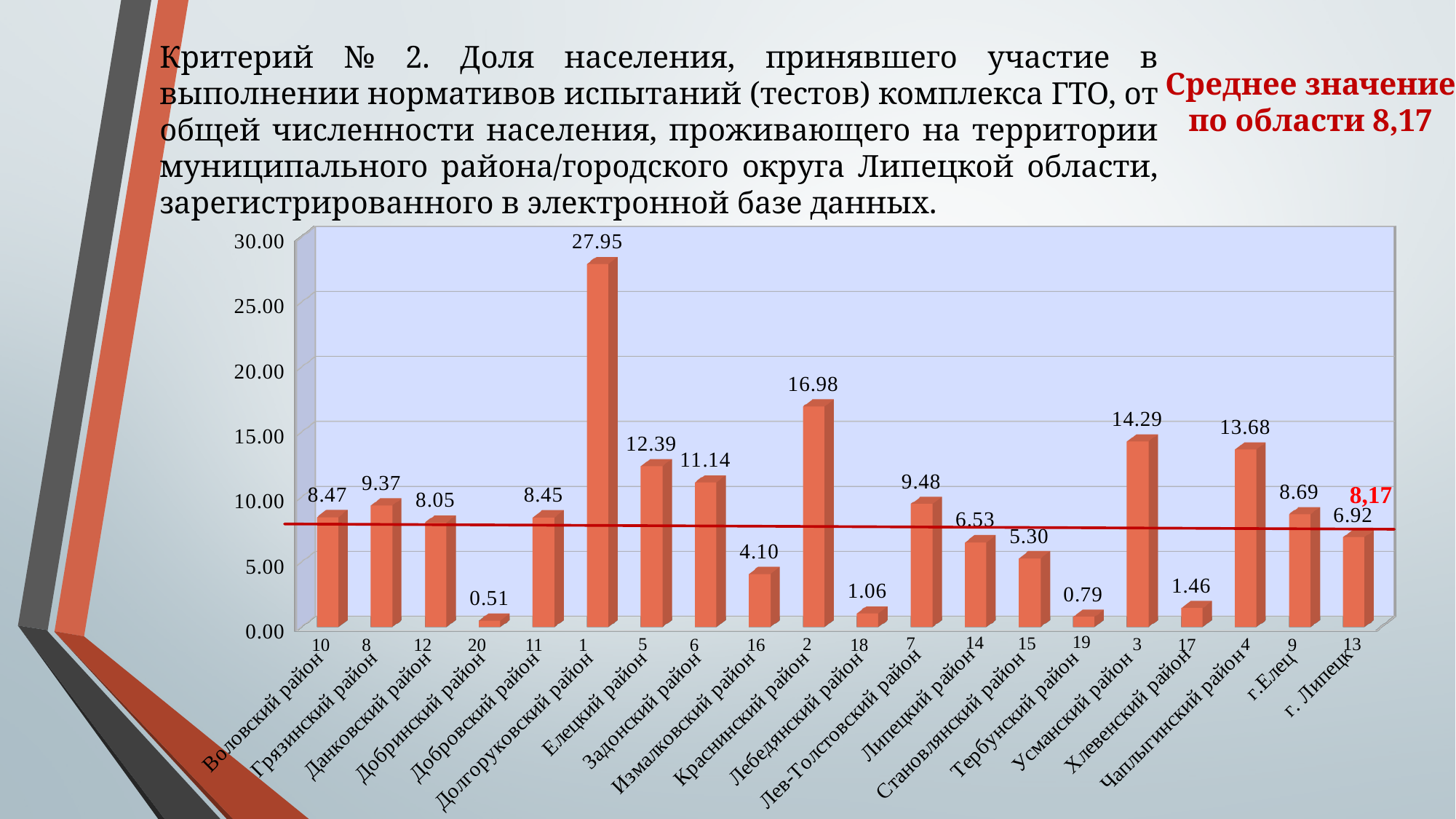
What is the regional average value marked by the red horizontal line? 8,17 Which district has the highest value on the chart? Долгоруковский район Which district has the lowest value on the chart? Добринский район What value is shown for Краснинский район? 16.98 Is the value for Измалковский район greater or less than 5.00? less What value is shown for Долгоруковский район? 27.95 What is the difference between the values for Усманский район and Чаплыгинский район? 0.61 How many districts/cities are shown on the chart? 20 What kind of chart is shown on the slide? bar chart Which is larger, the value for Елецкий район or the value for Задонский район? Елецкий район What value is shown for Тербунский район? 0.79 What value is shown for г. Липецк? 6.92